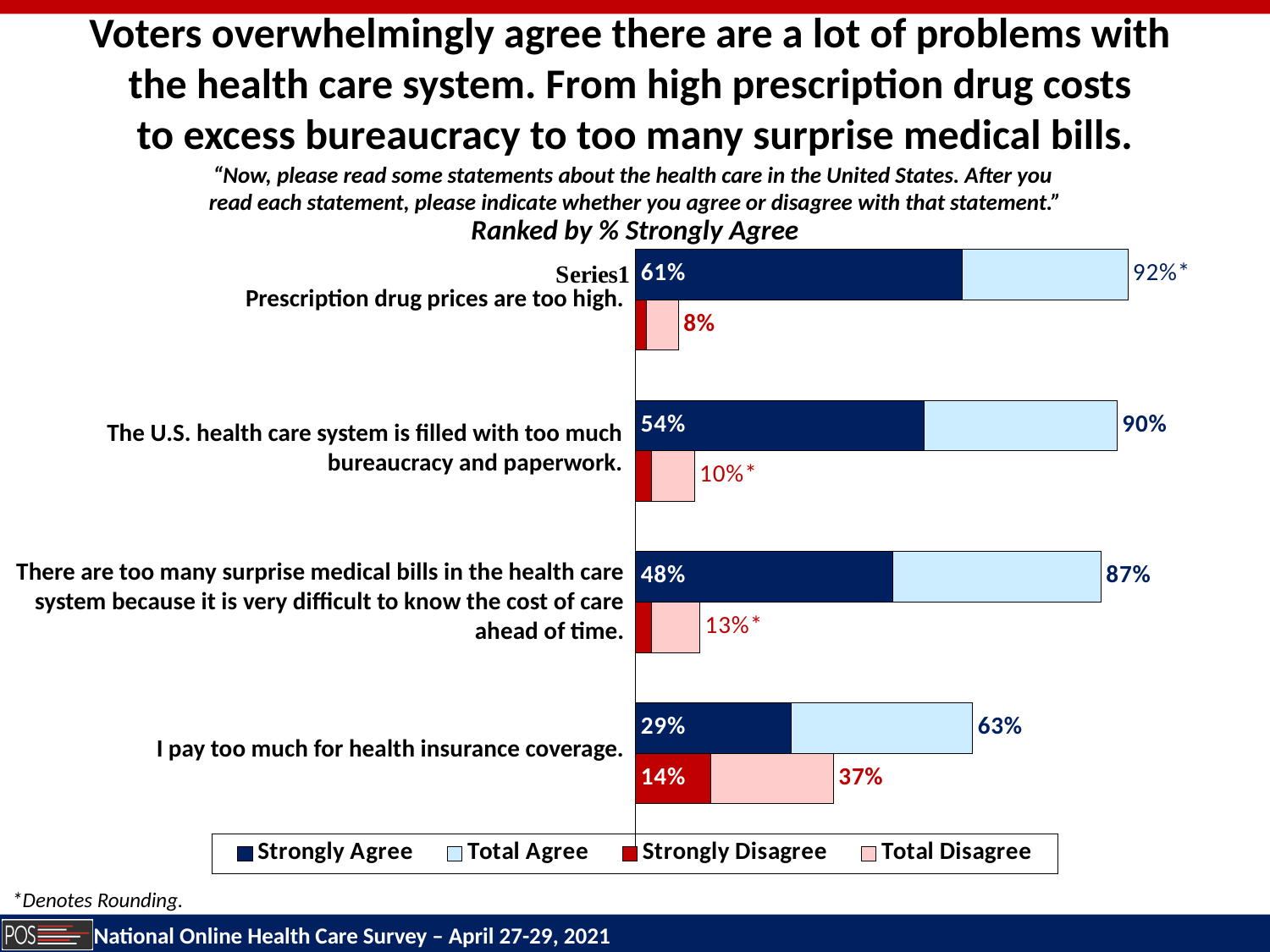
Which statement has the lowest Total Agree percentage? I pay too much for health insurance coverage. What type of chart is shown on the slide? Bar chart According to the subtitle, how are the statements in the chart ranked? By % Strongly Agree Which is larger: the Strongly Agree value for the bureaucracy statement or the Strongly Agree value for the surprise medical bills statement? The bureaucracy statement (54%) What is the difference between the Total Agree and Total Disagree values for "I pay too much for health insurance coverage"? 26% What percentage of voters strongly agree that prescription drug prices are too high? 61% Which statement has the highest Strongly Agree percentage? Prescription drug prices are too high. How many series does the legend list? 4 What percentage of voters strongly disagree with the statement "I pay too much for health insurance coverage"? 14% How many statements are shown in the chart? 4 What is the Total Agree value for the statement "The U.S. health care system is filled with too much bureaucracy and paperwork"? 90% What is the Total Disagree value for the statement about too many surprise medical bills? 13%